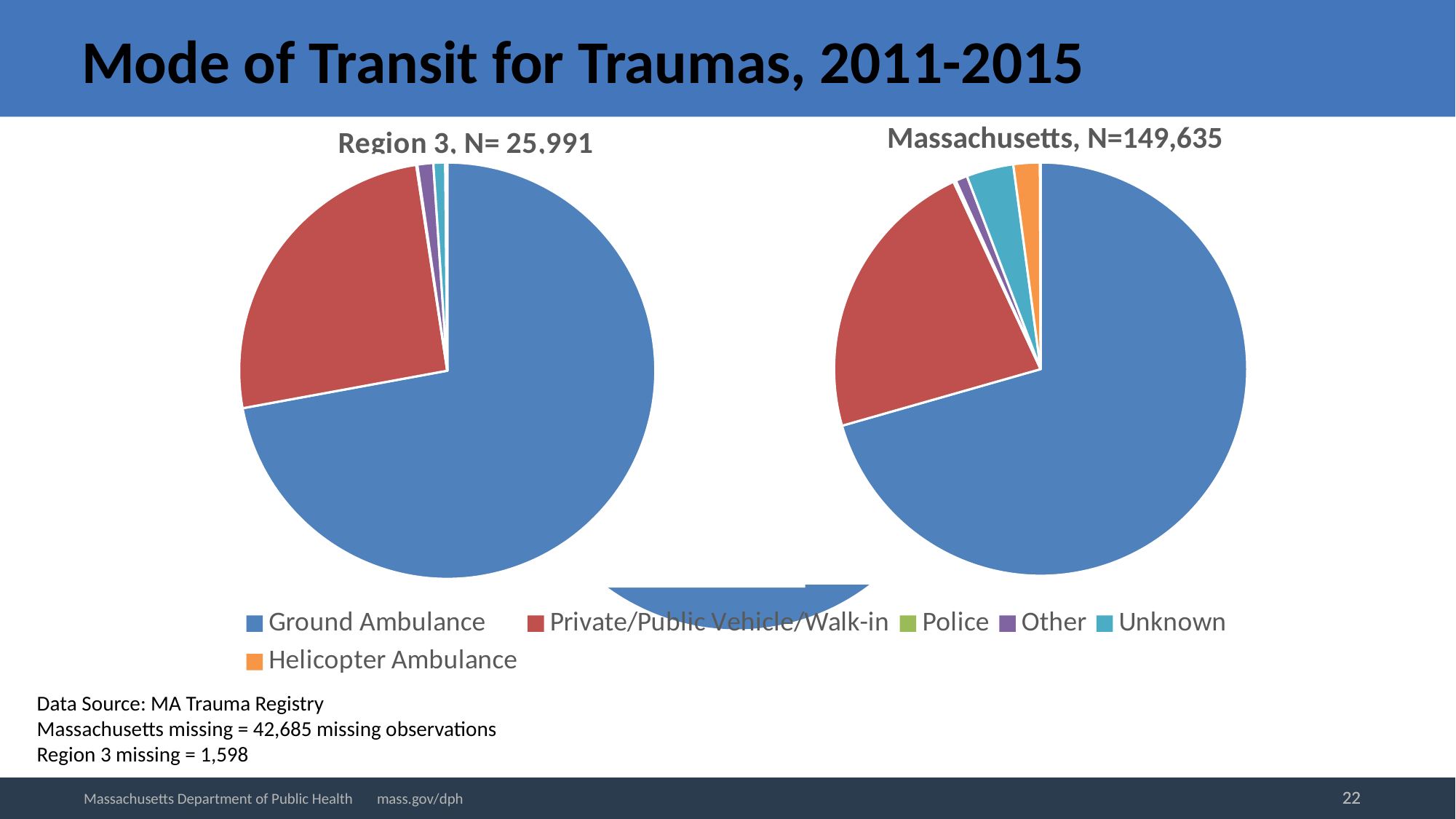
What is the N value shown in the title of the Massachusetts pie chart? 149,635 In the Massachusetts pie chart, which mode of transit has the largest share? Ground Ambulance In the Region 3 pie chart, which is larger: Private/Public Vehicle/Walk-in or Unknown? Private/Public Vehicle/Walk-in In the Region 3 pie chart, which mode of transit has the largest share? Ground Ambulance In the Region 3 pie chart, which mode of transit has the second largest share? Private/Public Vehicle/Walk-in In the Massachusetts pie chart, which is larger: Unknown or Other? Unknown How many categories does the legend list? 6 What kind of chart is used for Region 3 on the slide? pie chart How many charts are shown on the slide? 2 What is the N value shown in the title of the Region 3 pie chart? 25,991